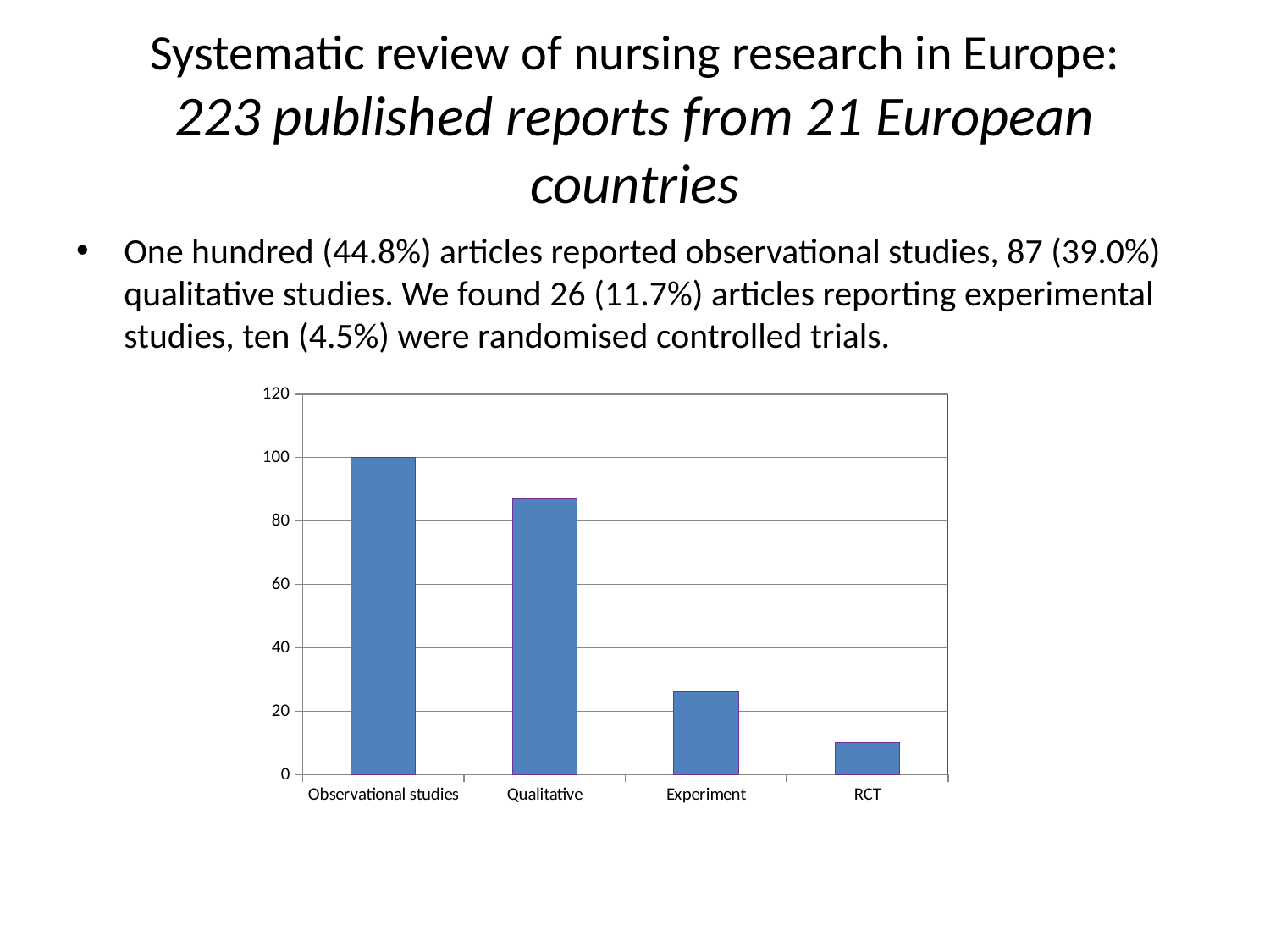
Which category has the highest bar in the chart? Observational studies How many categories are shown on the x axis of the chart? 4 Is the value for Qualitative greater or less than 80? greater Is the value for Experiment greater or less than 40? less What is the highest value shown on the y axis of the chart? 120 Is the value for RCT greater or less than 20? less Which is larger in the chart, the value for Qualitative or the value for Experiment? Qualitative Which category has the lowest bar in the chart? RCT What colour are the bars in the chart? blue Do the bar values rise or fall from left to right along the x axis? fall What is the value for Observational studies in the chart? 100 What kind of chart is shown on the slide? bar chart